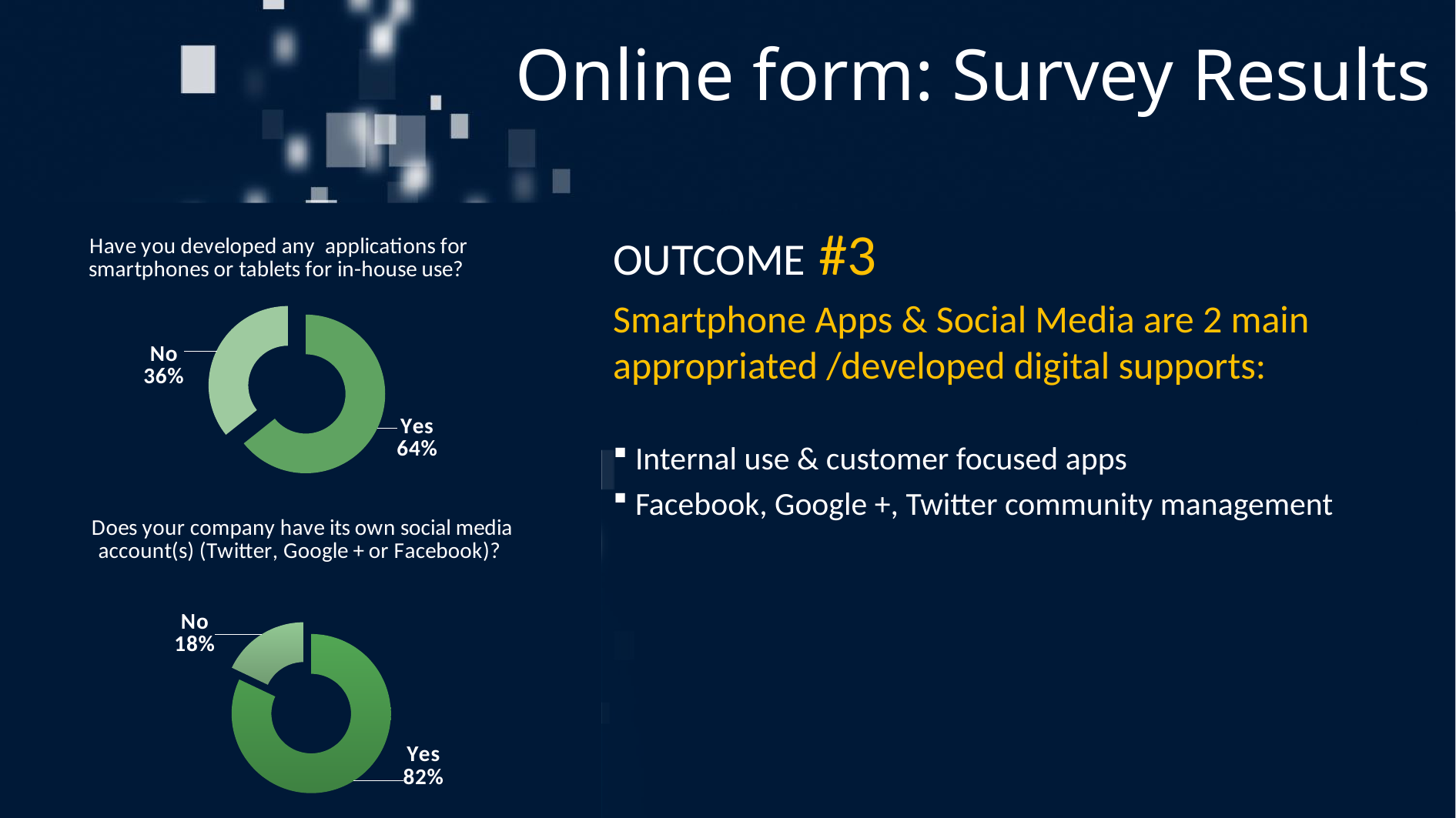
In the top chart about in-house smartphone applications, which answer has the larger share? Yes In the bottom chart about social media accounts, which answer has the smaller share? No What kind of chart is used for the top chart about in-house smartphone applications? Doughnut (pie) chart Is the Yes share larger in the top chart (in-house applications) or in the bottom chart (social media accounts)? Bottom chart (social media accounts) In the top chart ("Have you developed any applications for smartphones or tablets for in-house use?"), what percentage answered No? 36% In the bottom chart ("Does your company have its own social media account(s)?"), what percentage answered Yes? 82% In the top chart ("Have you developed any applications for smartphones or tablets for in-house use?"), what percentage answered Yes? 64% In the bottom chart about social media accounts, what is the difference in percentage points between Yes and No? 64 How many categories does the bottom chart about social media accounts show? 2 In the top chart about in-house smartphone applications, what is the difference in percentage points between Yes and No? 28 In the bottom chart ("Does your company have its own social media account(s)?"), what percentage answered No? 18% How many charts are shown on the slide? 2